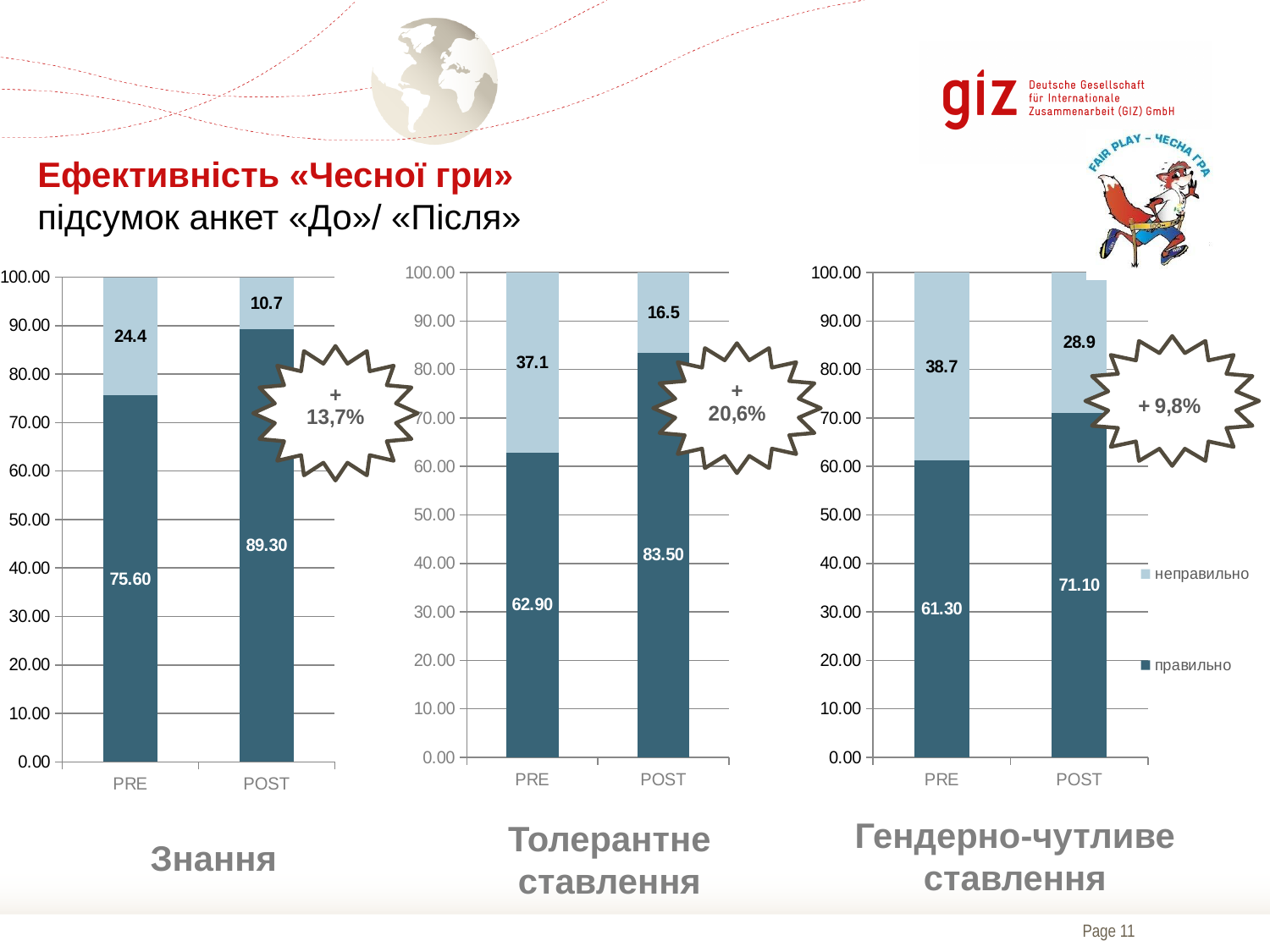
In the left chart (Знання), what is the value of неправильно for POST? 10.7 In the right chart (Гендерно-чутливе ставлення), what is the value of неправильно for POST? 28.9 In the right chart (Гендерно-чутливе ставлення), what is the total of the stacked bar for PRE? 100.00 How many series does the legend on the right chart list? 2 In the left chart (Знання), what is the difference between the правильно values for POST and PRE? 13.70 In the middle chart (Толерантне ставлення), which category has the higher правильно value, PRE or POST? POST In the middle chart (Толерантне ставлення), what is the value of неправильно for PRE? 37.1 In the right chart (Гендерно-чутливе ставлення), what is the value of правильно for PRE? 61.30 In the middle chart (Толерантне ставлення), what is the value of правильно for POST? 83.50 How many categories are shown on the x axis of the left chart (Знання)? 2 What kind of chart is the middle chart (Толерантне ставлення)? Stacked bar chart In the left chart (Знання), what is the value of правильно for PRE? 75.60